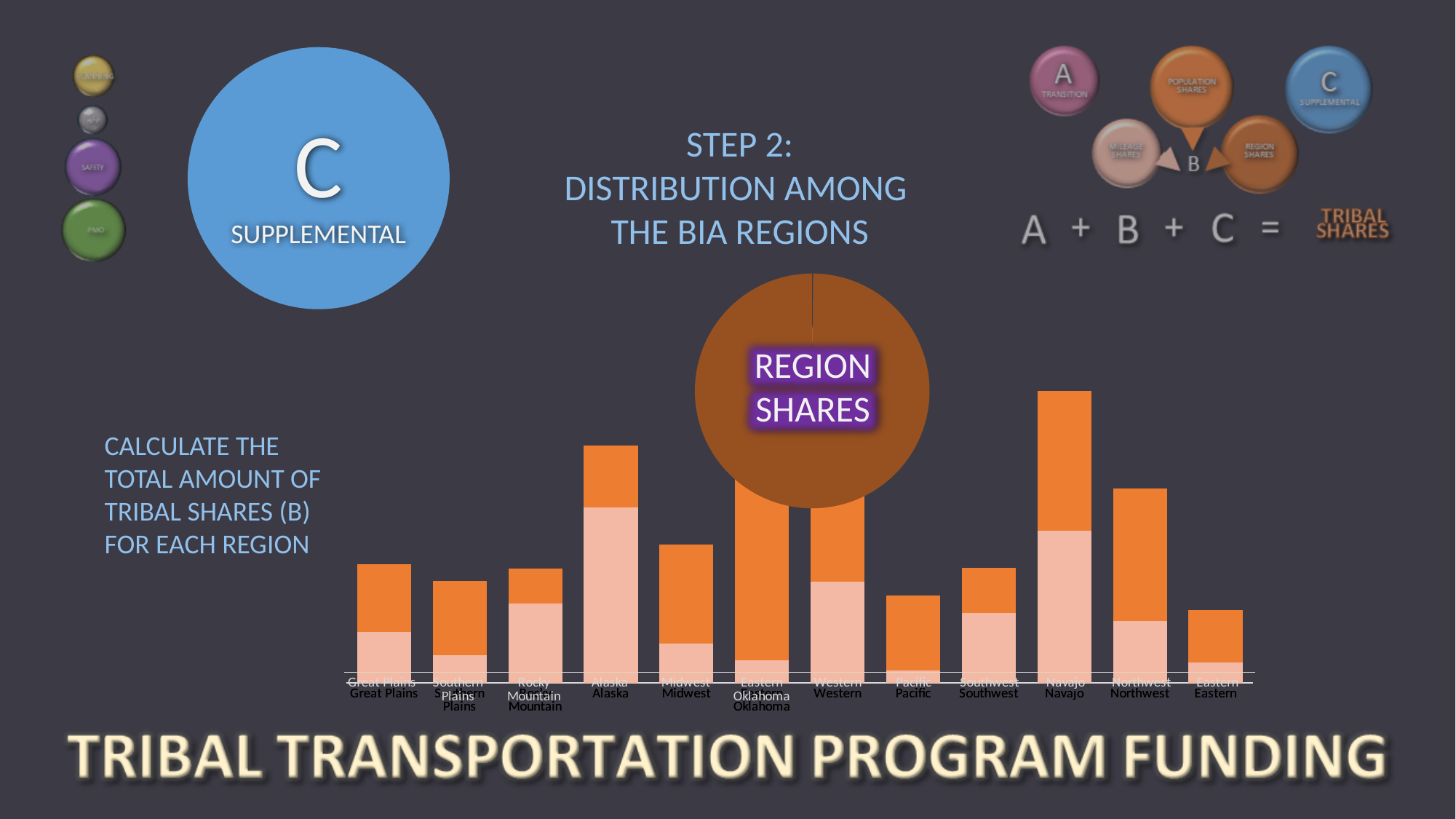
Which bar is taller, Southwest or Northwest? Northwest Which bar is taller, Alaska or Navajo? Navajo Which region's bar is the first category on the left of the x axis? Great Plains How many regions (categories) are shown along the x axis of the bar chart? 12 Which bar is taller, Alaska or Midwest? Alaska What label is shown in the circle overlaying the top of the bar chart? REGION SHARES What kind of chart is shown on the slide? stacked bar chart